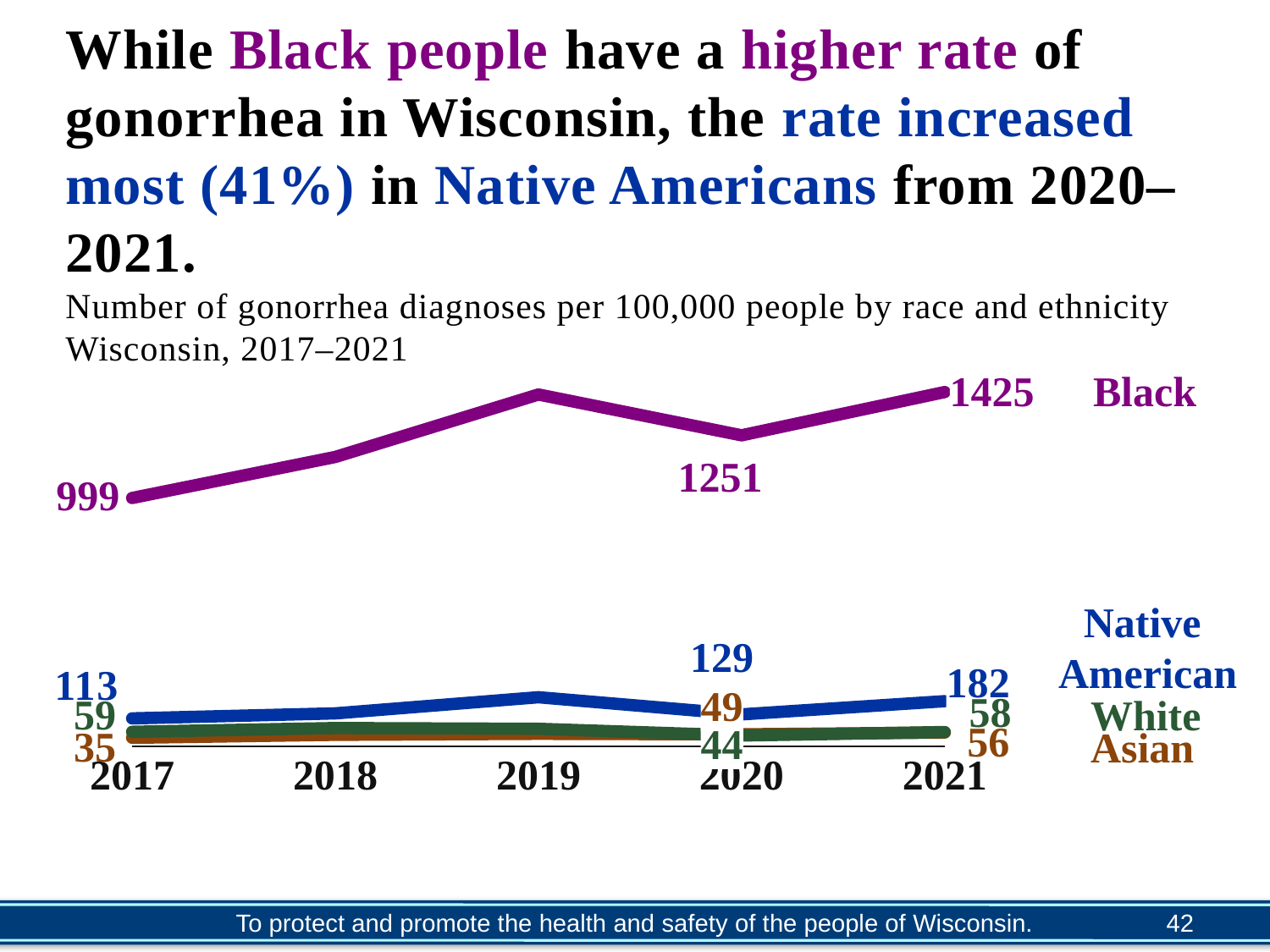
What was the rate for Asian people in 2021? 56 In 2020, which group had the higher rate, White or Asian? Asian What was the gonorrhea rate per 100,000 for Black people in 2021? 1425 How many race/ethnicity groups are plotted as lines? 4 Which group had the highest rate in 2021? Black What was the rate for White people in 2020? 44 What was the rate for Native Americans in 2017? 113 What kind of chart is shown on the slide? line chart By how much did the rate for Black people increase from 2020 to 2021? 174 What is the difference between the Native American rate in 2021 and in 2017? 69 Which group had the lowest rate in 2017? Asian How many years are shown on the x axis? 5